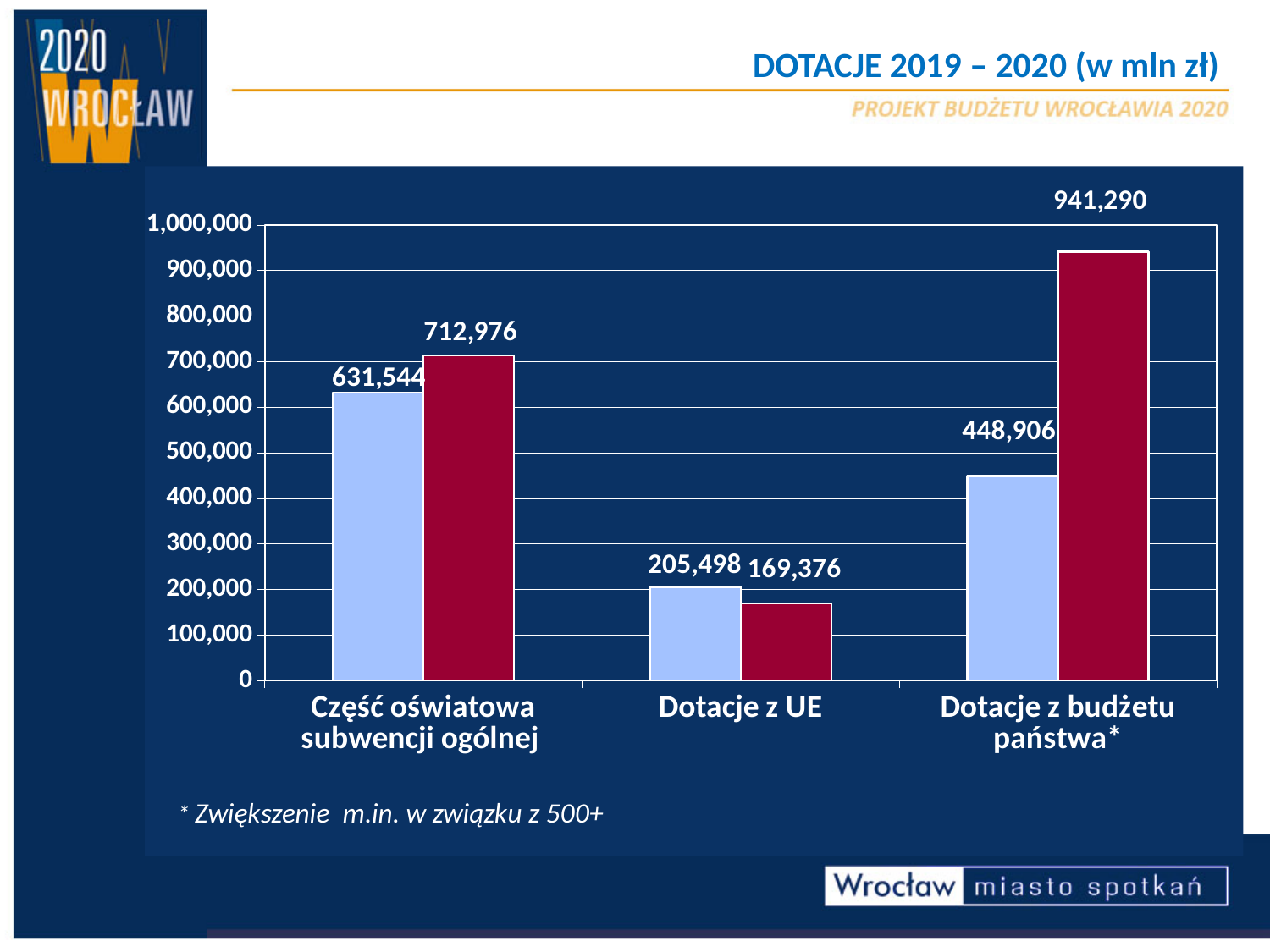
How many categories are shown on the x axis? 3 What is the title of the chart? DOTACJE 2019 – 2020 (w mln zł) Which category has the lowest light blue bar? Dotacje z UE What is the value of the dark red bar for Dotacje z budżetu państwa*? 941,290 What is the value of the light blue bar for Część oświatowa subwencji ogólnej? 631,544 What is the value of the dark red bar for Dotacje z UE? 169,376 What is the difference between the dark red and light blue bars for Dotacje z budżetu państwa*? 492,384 What is the value of the light blue bar for Dotacje z UE? 205,498 For Dotacje z UE, which bar is larger, the light blue or the dark red? light blue What type of chart is shown on the slide? bar chart What is the difference between the dark red and light blue bars for Część oświatowa subwencji ogólnej? 81,432 Which category has the highest dark red bar? Dotacje z budżetu państwa*